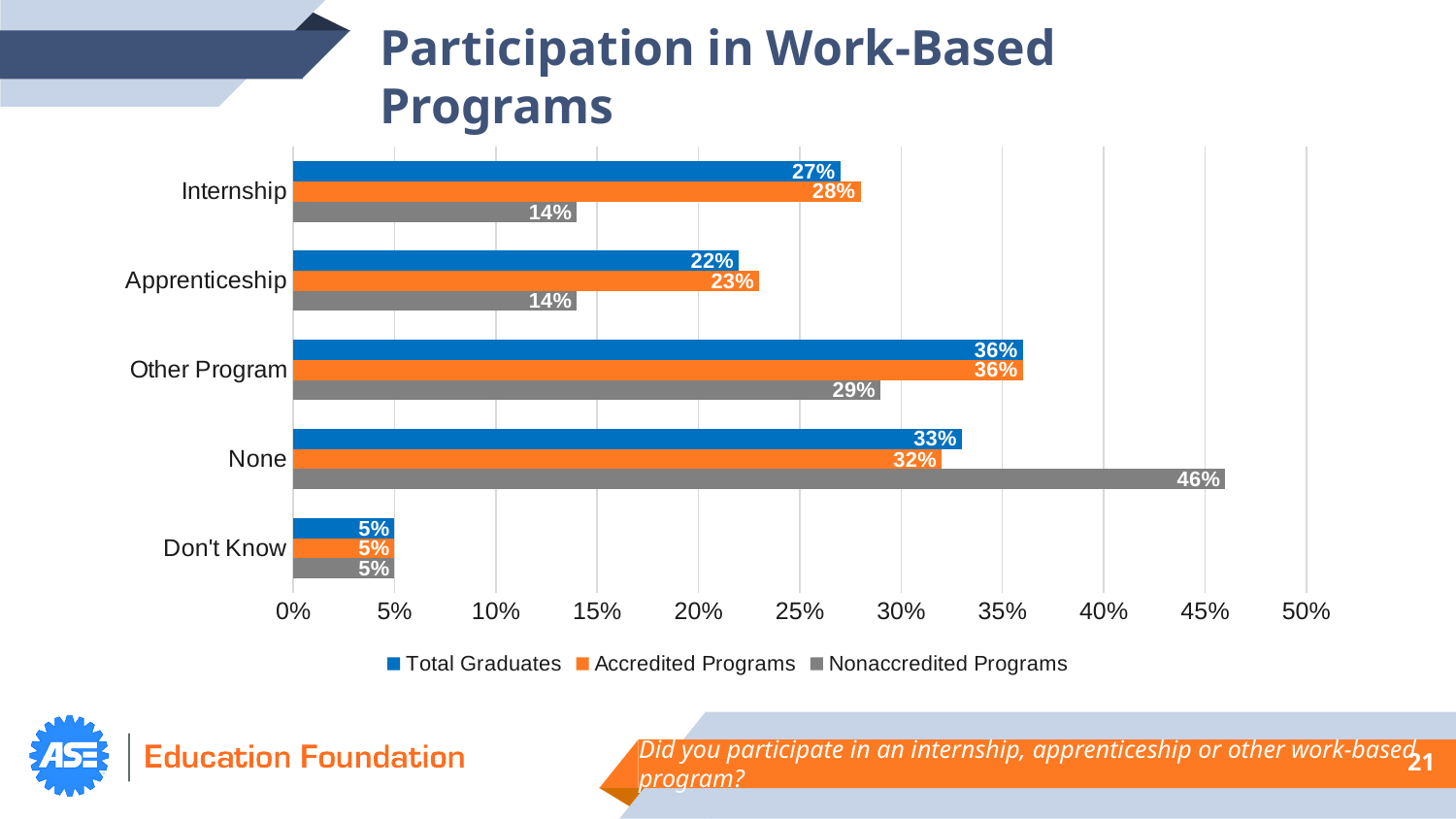
Which category has the highest Nonaccredited Programs value? None What is the Total Graduates value for Apprenticeship? 22% Which series is shown in orange? Accredited Programs What is the title of the chart? Participation in Work-Based Programs What kind of chart is shown on the slide? Bar chart What is the difference between the Nonaccredited Programs value for None and the Nonaccredited Programs value for Other Program? 17% How many series does the legend list? 3 What is the Nonaccredited Programs value for None? 46% How many categories are shown on the chart? 5 Which is larger for Internship: the Accredited Programs value or the Nonaccredited Programs value? Accredited Programs What is the Accredited Programs value for Internship? 28% Which category has the lowest Total Graduates value? Don't Know